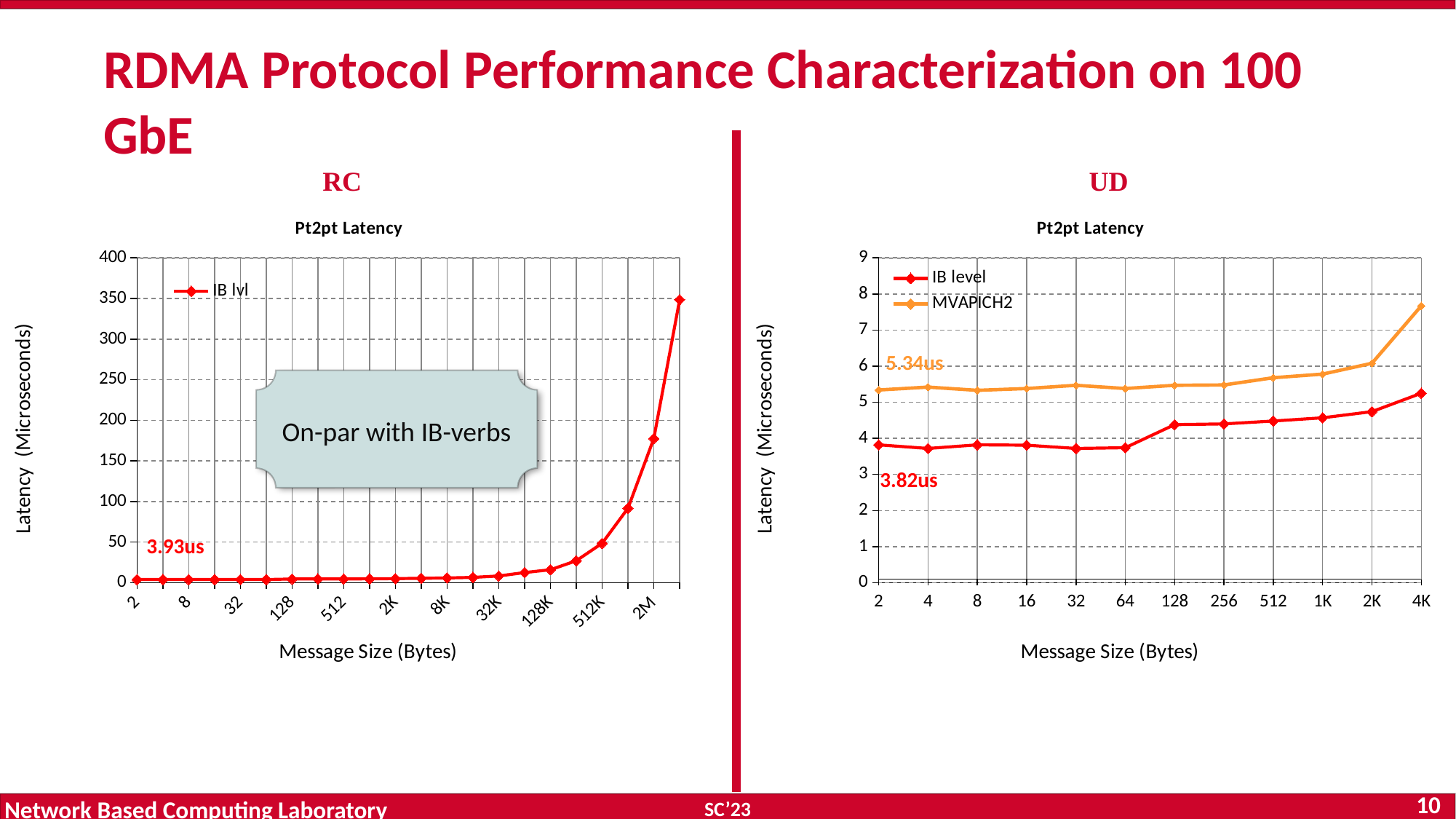
In the UD Pt2pt Latency chart on the right, at which message size is the IB level latency highest? 4K How many series does the legend of the UD Pt2pt Latency chart on the right list? 2 In the RC Pt2pt Latency chart on the left, does the IB lvl latency rise or fall as message size increases? rise In the UD Pt2pt Latency chart on the right, is the MVAPICH2 latency at 4K greater or less than 7? greater How many message sizes are labelled on the x axis of the UD Pt2pt Latency chart on the right? 12 In the RC Pt2pt Latency chart on the left, is the IB lvl latency at 2M greater or less than 150? greater What latency value is annotated for MVAPICH2 on the UD Pt2pt Latency chart on the right? 5.34us What latency value is annotated on the RC Pt2pt Latency chart on the left? 3.93us What latency value is annotated for IB level on the UD Pt2pt Latency chart on the right? 3.82us What are the legend entries of the UD Pt2pt Latency chart on the right? IB level, MVAPICH2 What kind of chart is the RC Pt2pt Latency chart on the left? line chart In the UD Pt2pt Latency chart on the right, which series has the higher latency at message size 4K? MVAPICH2